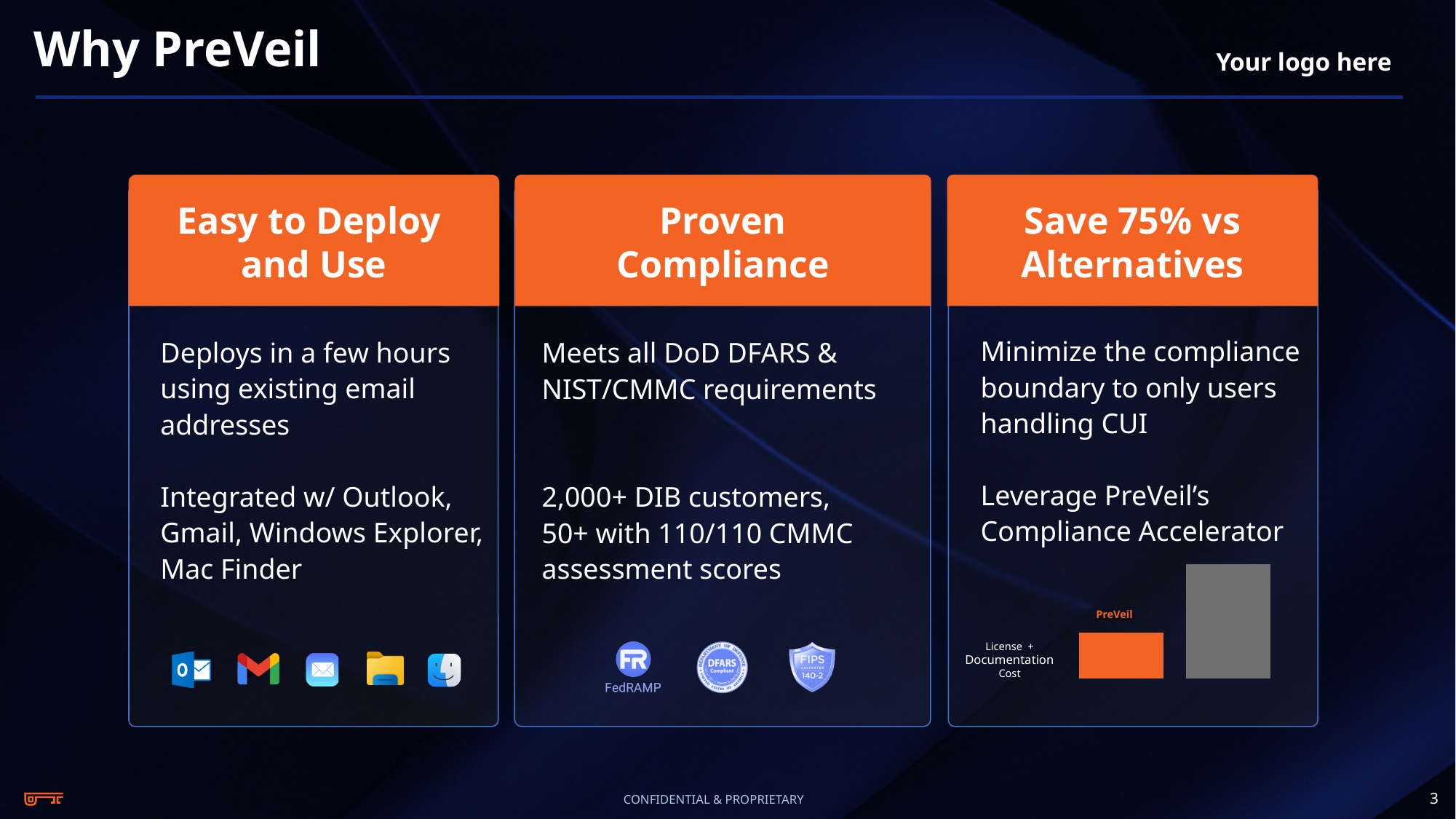
What label appears to the left of the bars in the chart in the 'Save 75% vs Alternatives' card? License + Documentation Cost In the chart in the 'Save 75% vs Alternatives' card, is the PreVeil bar shorter or taller than the gray bar? shorter What colour is the PreVeil bar in the chart in the 'Save 75% vs Alternatives' card? orange How many bars does the chart in the 'Save 75% vs Alternatives' card show? 2 What kind of chart is shown in the 'Save 75% vs Alternatives' card? bar chart In the chart in the 'Save 75% vs Alternatives' card, which bar is taller, the orange PreVeil bar or the gray bar? the gray bar